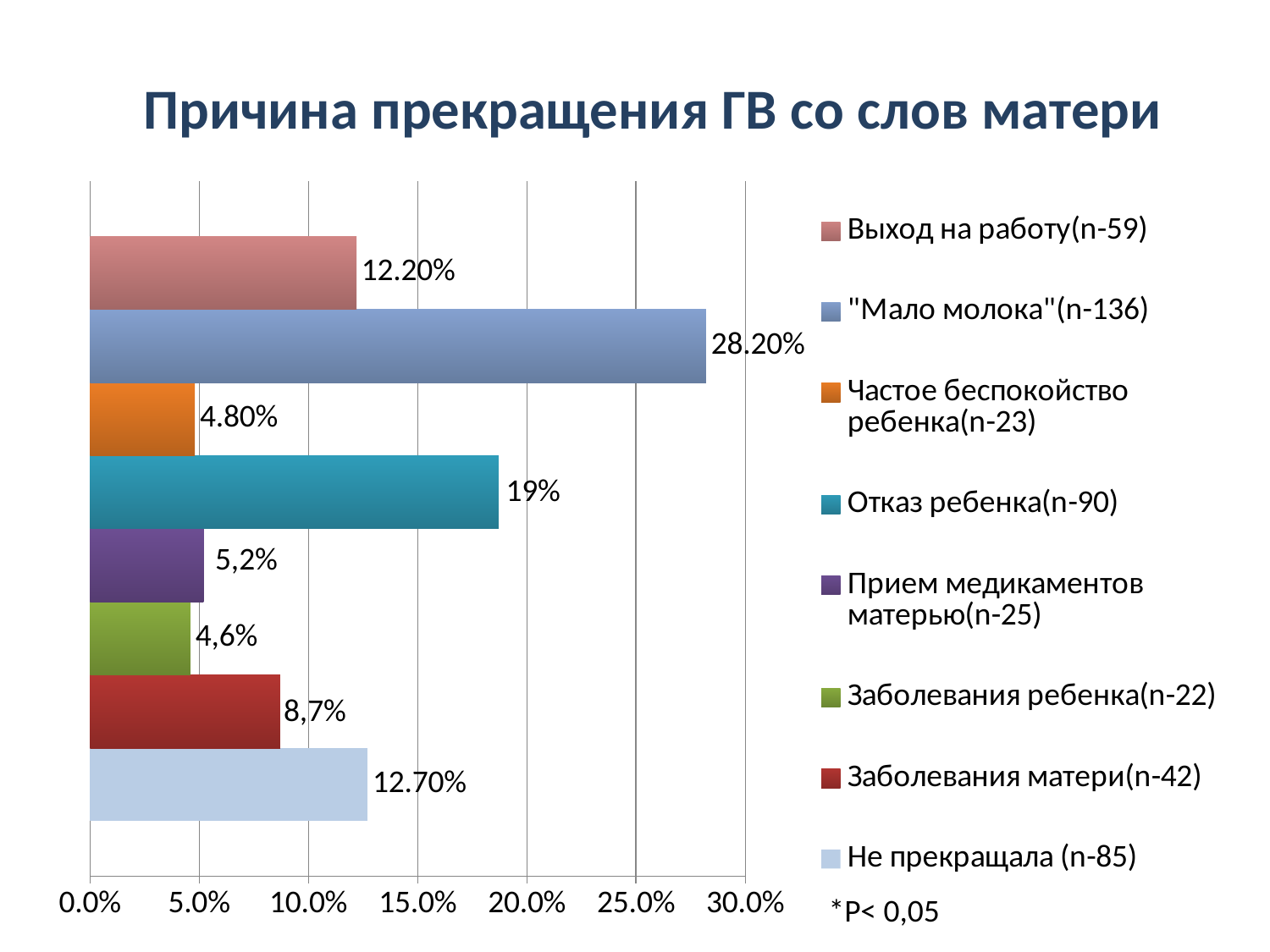
What type of chart is shown on the slide? Bar chart How many entries does the legend list? 8 What is the difference between the values for "Мало молока"(n-136) and Отказ ребенка(n-90)? 9.20% What is the title of the chart? Причина прекращения ГВ со слов матери Which category has the highest value? "Мало молока"(n-136) What is the value for "Мало молока"(n-136)? 28.20% How many bars are plotted in the chart? 8 Which is larger, the value for Выход на работу(n-59) or the value for Не прекращала (n-85)? Не прекращала (n-85) What is the value for Не прекращала (n-85)? 12.70% Which category has the lowest value? Заболевания ребенка(n-22) What is the value for Заболевания матери(n-42)? 8,7% What is the value for Отказ ребенка(n-90)? 19%